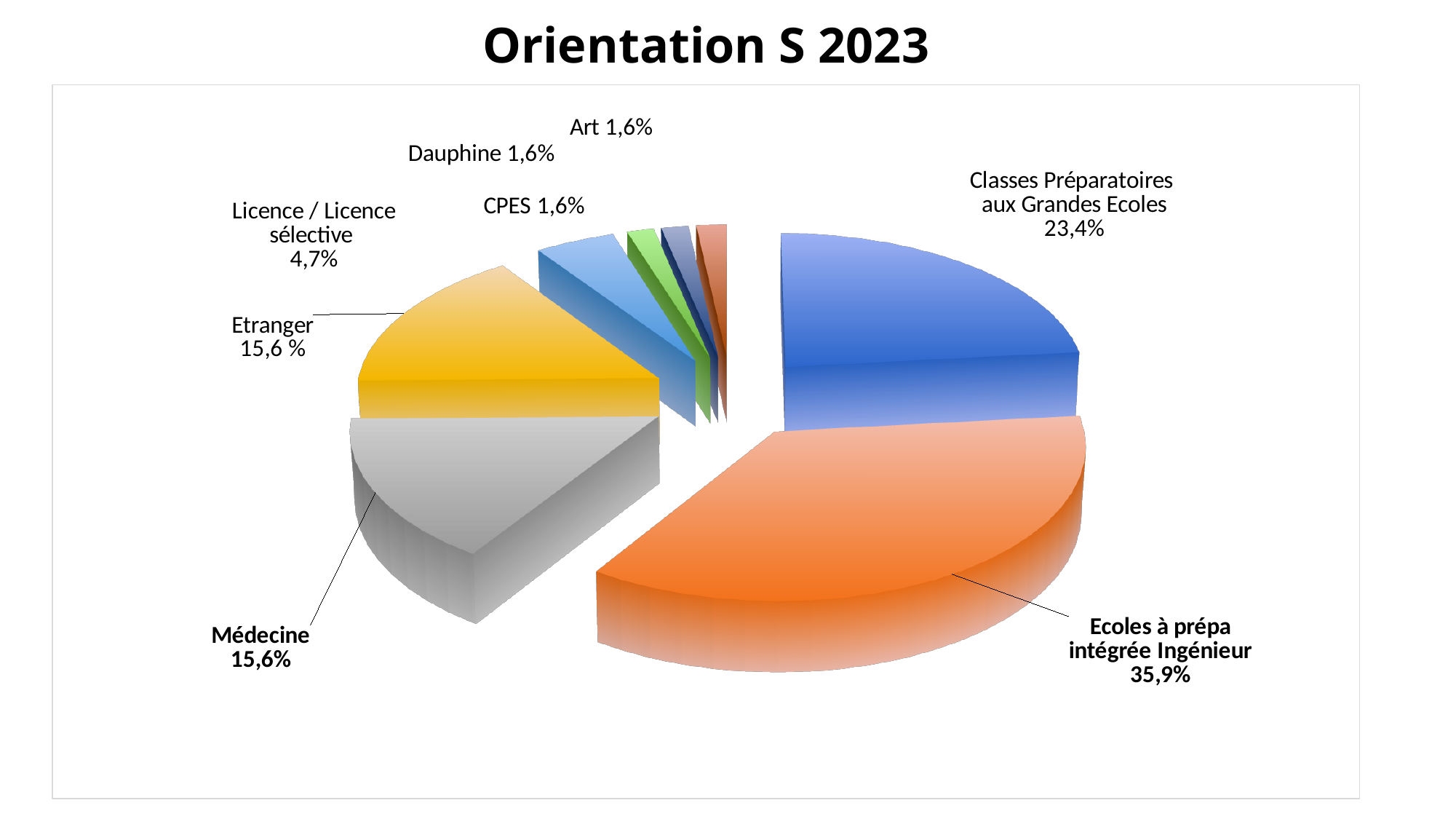
What is the difference between the shares for Ecoles à prépa intégrée Ingénieur and Classes Préparatoires aux Grandes Ecoles? 12,5% What share of the pie is labelled for Classes Préparatoires aux Grandes Ecoles? 23,4% Which is larger, the share for Etranger or the share for Licence / Licence sélective? Etranger What value is shown for CPES? 1,6% What colour is the slice for Médecine? Grey What is the chart's title? Orientation S 2023 What kind of chart is shown on the slide? Pie chart How many slices does the pie chart have? 8 What share of the pie is labelled for Ecoles à prépa intégrée Ingénieur? 35,9% Which category has the largest slice of the pie? Ecoles à prépa intégrée Ingénieur What value is shown for Licence / Licence sélective? 4,7% What value is shown for Médecine? 15,6%